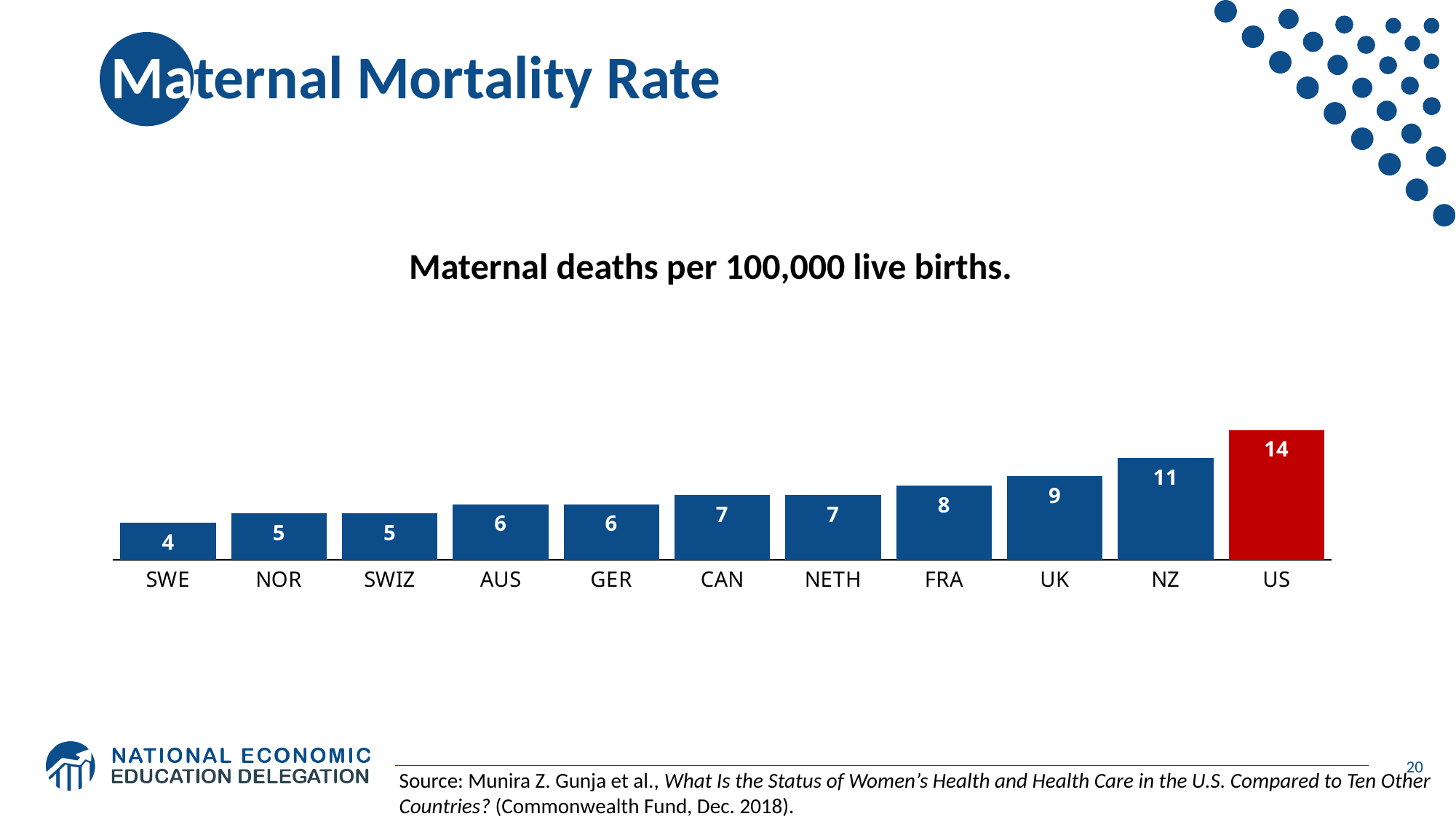
Which country has the lowest maternal mortality rate on the chart? SWE Which has a higher value, UK or CAN? UK What is the value shown for FRA? 8 How many countries are shown on the chart? 11 What is the value shown for NZ? 11 What kind of chart is shown on the slide? Bar chart Which country has the highest maternal mortality rate on the chart? US What is the value shown for SWE? 4 What is the difference between the values for NZ and UK? 2 Which bar is coloured red rather than blue? US What is the difference between the values for the US and SWE? 10 What is the maternal mortality rate shown for the US? 14